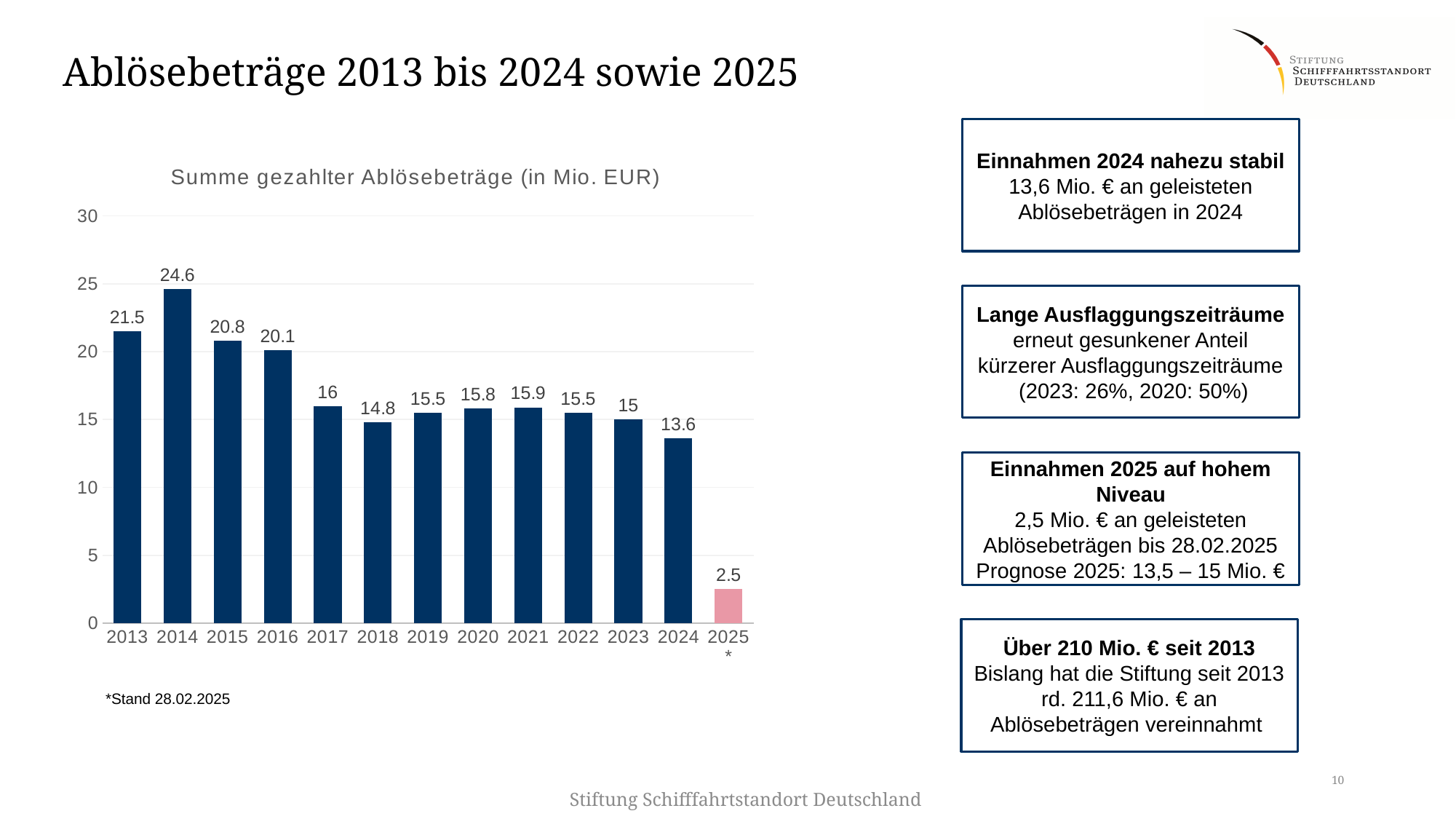
Do the values generally rise or fall from 2014 to 2024? Fall What is the value for 2024 in the chart? 13.6 What is the difference between the values for 2013 and 2024? 7.9 Which is larger, the value for 2017 or the value for 2023? 2017 How many years are shown on the x axis of the chart? 13 What is the title of the chart? Summe gezahlter Ablösebeträge (in Mio. EUR) Which year has the highest value in the chart? 2014 What is the value for 2018 in the chart? 14.8 What kind of chart is shown on the slide? Bar chart What is the value for 2014 in the chart? 24.6 Is the value for 2016 greater or less than 20? greater Which year has the lowest value in the chart? 2025